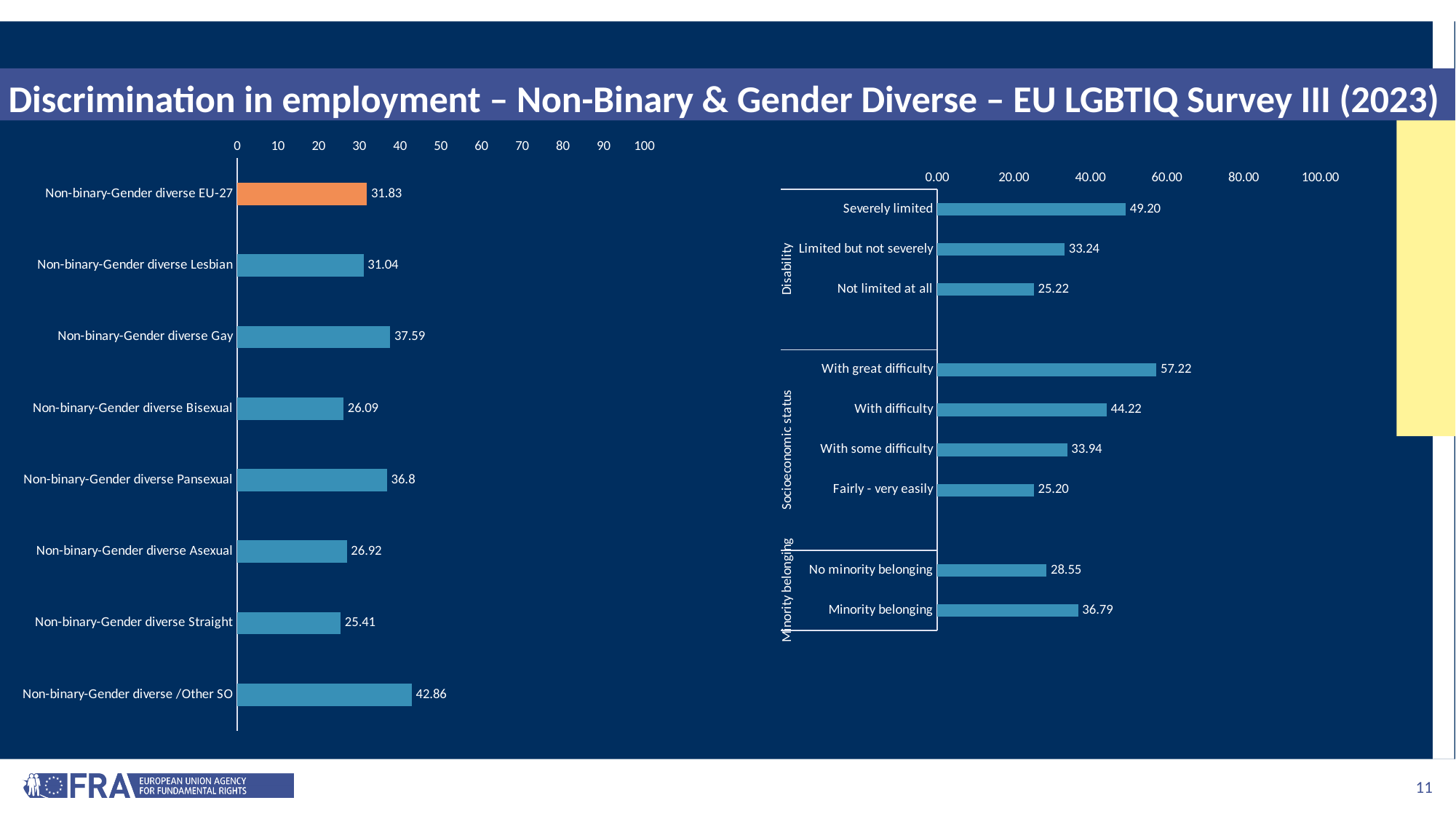
In the chart on the right of the slide, which is larger: the value for With difficulty or the value for With some difficulty? With difficulty In the chart on the right of the slide, what is the value for Minority belonging? 36.79 In the chart on the left of the slide, what is the value for Non-binary-Gender diverse Pansexual? 36.8 In the chart on the left of the slide, which category has the lowest value? Non-binary-Gender diverse Straight In the chart on the right of the slide, what is the difference between the values for With great difficulty and Fairly - very easily? 32.02 In the chart on the left of the slide, how many categories are plotted? 8 In the chart on the left of the slide, which category has the highest value? Non-binary-Gender diverse /Other SO In the chart on the left of the slide, what is the difference between the values for Non-binary-Gender diverse /Other SO and Non-binary-Gender diverse Straight? 17.45 In the chart on the right of the slide, what is the value for Severely limited? 49.20 In the chart on the left of the slide, what is the value for Non-binary-Gender diverse EU-27? 31.83 In the chart on the right of the slide, which category has the highest value? With great difficulty What kind of chart is shown on the left of the slide? Bar chart